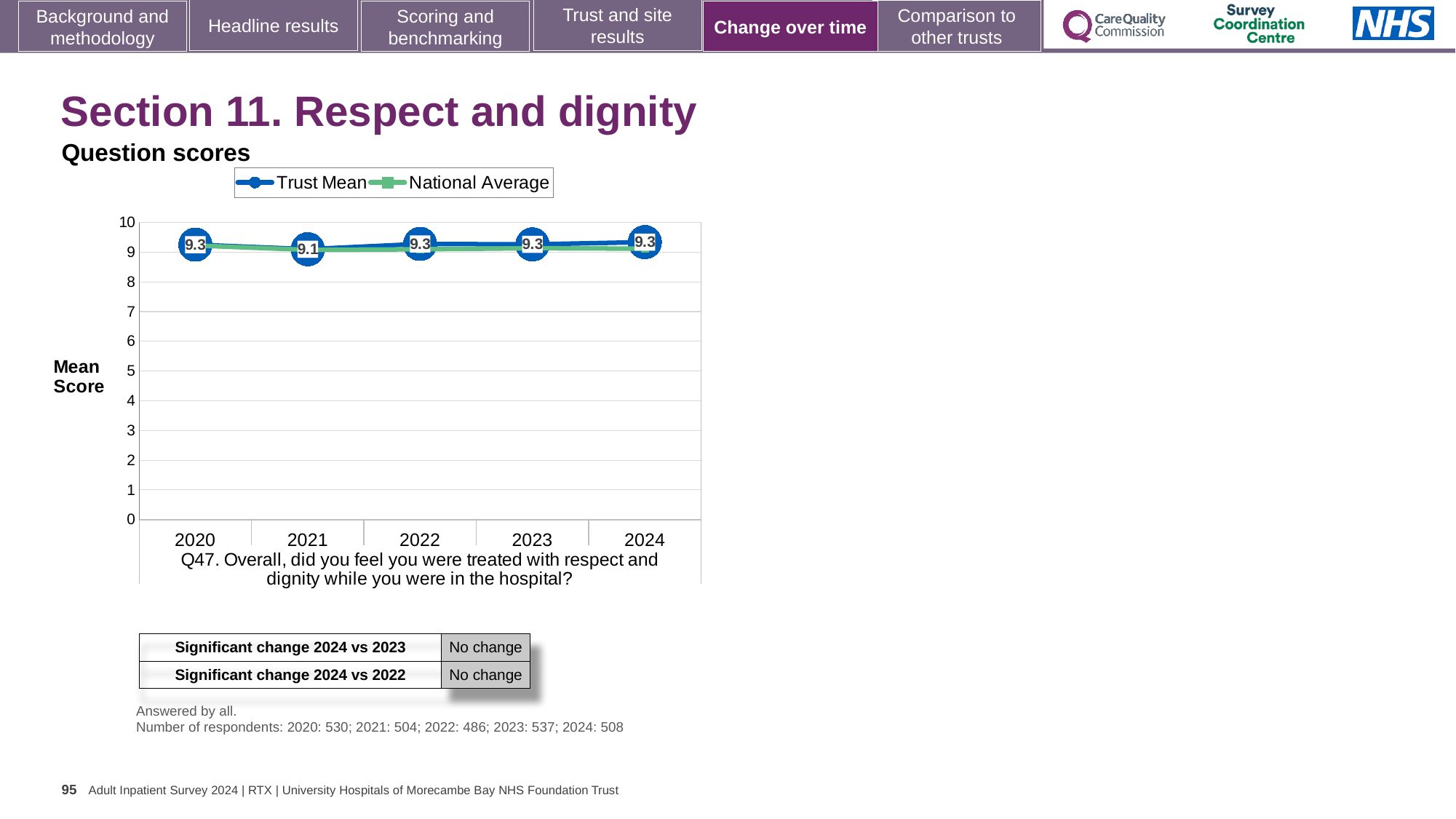
Which year has the lowest Trust Mean score? 2021 Is the National Average for 2023 greater or less than 8? greater How many years are shown on the x axis of the chart? 5 What kind of chart is shown on the slide? Line chart Which series is drawn in blue in the chart? Trust Mean Is the Trust Mean score for 2021 greater or less than 9? greater How many series does the chart legend list? 2 What is the Trust Mean score for 2020? 9.3 What is the difference between the Trust Mean score in 2022 and in 2021? 0.2 What is the label on the y axis of the chart? Mean Score What is the Trust Mean score for 2021? 9.1 What is the Trust Mean score for 2024? 9.3